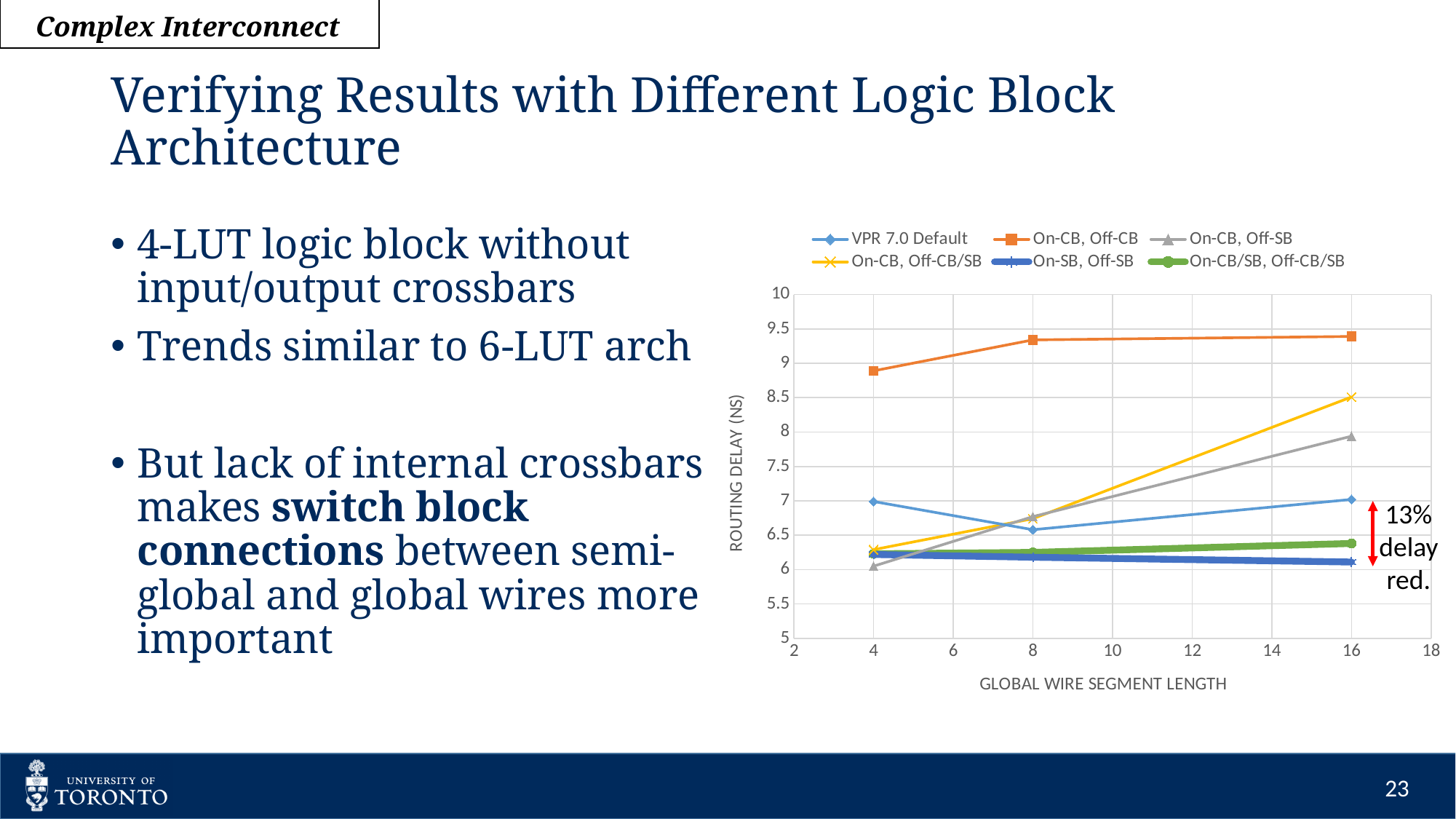
How many series does the chart legend list? 6 At how many global wire segment lengths are data points plotted for each series? 3 Which series has the highest routing delay at global wire segment length 16? On-CB, Off-CB Is the routing delay for On-CB, Off-CB at segment length 16 greater or less than 9? greater At segment length 16, which has the higher routing delay: On-CB, Off-CB/SB or On-CB, Off-SB? On-CB, Off-CB/SB Which series has the lowest routing delay at global wire segment length 16? On-SB, Off-SB Is the routing delay for On-CB, Off-CB/SB at segment length 16 greater or less than 8? greater What is the title of the chart's y axis? ROUTING DELAY (NS) Is the routing delay for VPR 7.0 Default at segment length 4 greater or less than 7.5? less Does the routing delay for On-CB, Off-CB/SB rise or fall as global wire segment length increases? rise What kind of chart is shown on the slide? line chart